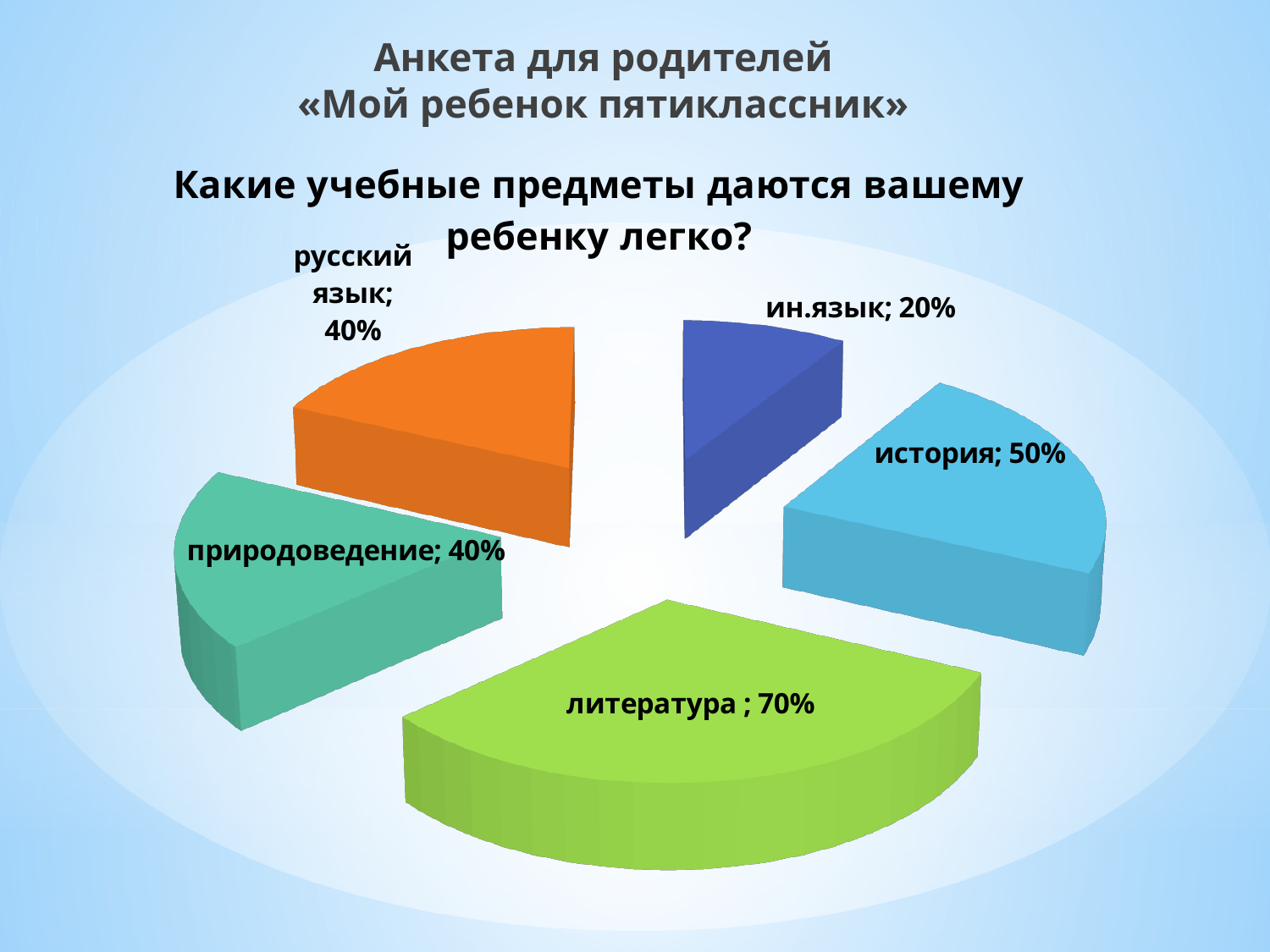
What is the value shown for история? 50% Which has a larger value, история or природоведение? история What is the difference between the values for литература and ин.язык? 50% Which subject has the highest value in the chart? литература What question does the chart title ask? Какие учебные предметы даются вашему ребенку легко? What is the value shown for литература? 70% How many subjects (slices) are shown in the chart? 5 What kind of chart is shown on the slide? pie chart Which subject has the lowest value in the chart? ин.язык What is the value shown for природоведение? 40% What is the value shown for ин.язык? 20% What is the value shown for русский язык? 40%